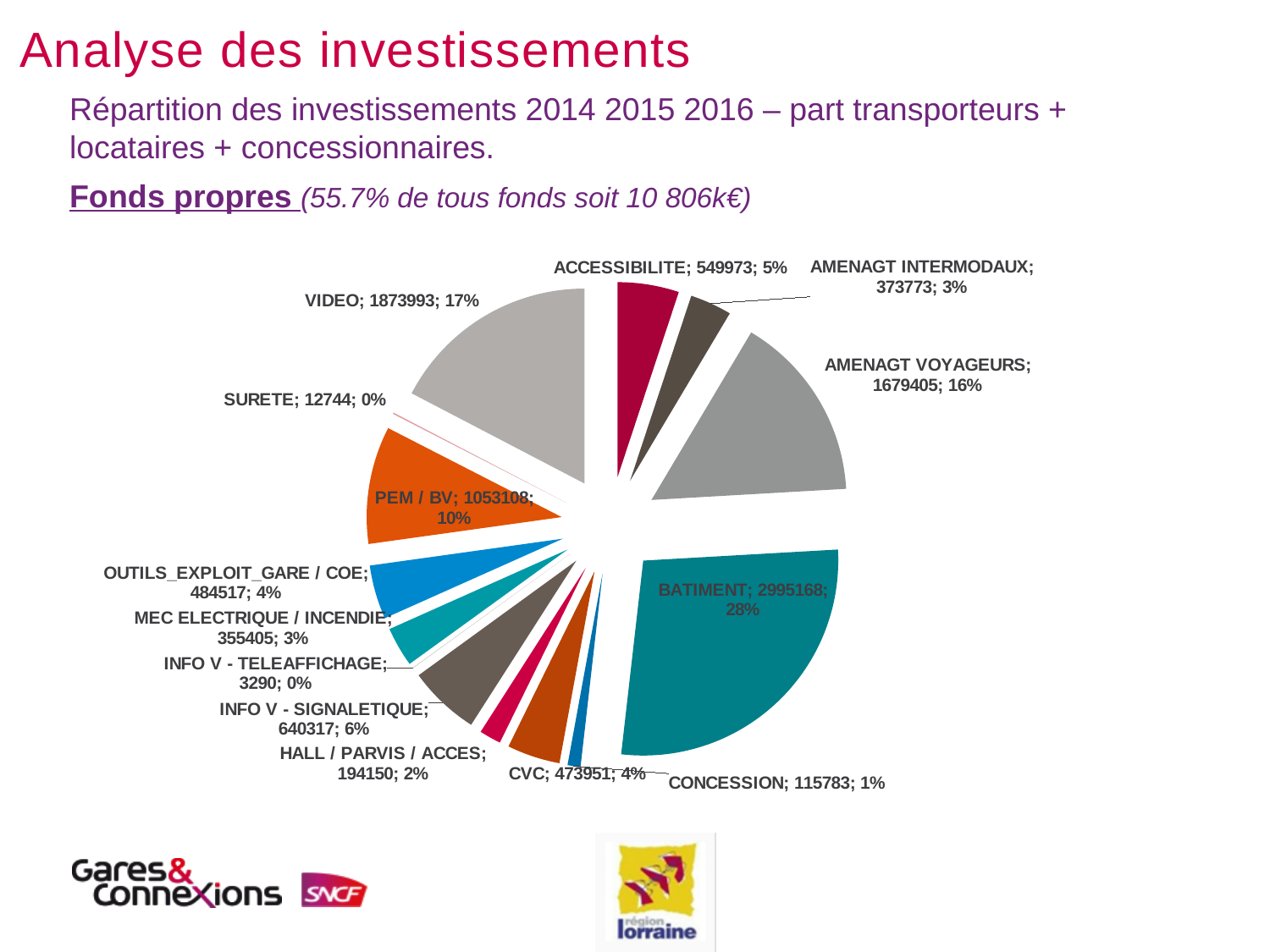
Which is larger, the value for OUTILS_EXPLOIT_GARE / COE or the value for CVC? OUTILS_EXPLOIT_GARE / COE What share of the pie does CONCESSION represent? 1% What is the value for VIDEO? 1873993 What is the value for PEM / BV? 1053108 How many categories (slices) does the pie chart show? 14 What share of the pie does AMENAGT VOYAGEURS represent? 16% What is the value for INFO V - SIGNALETIQUE? 640317 Which category has the largest share of the pie? BATIMENT What is the difference between the values for BATIMENT and VIDEO? 1121175 Which category has the smallest value? INFO V - TELEAFFICHAGE What kind of chart is shown on the slide? pie chart What is the value for BATIMENT? 2995168